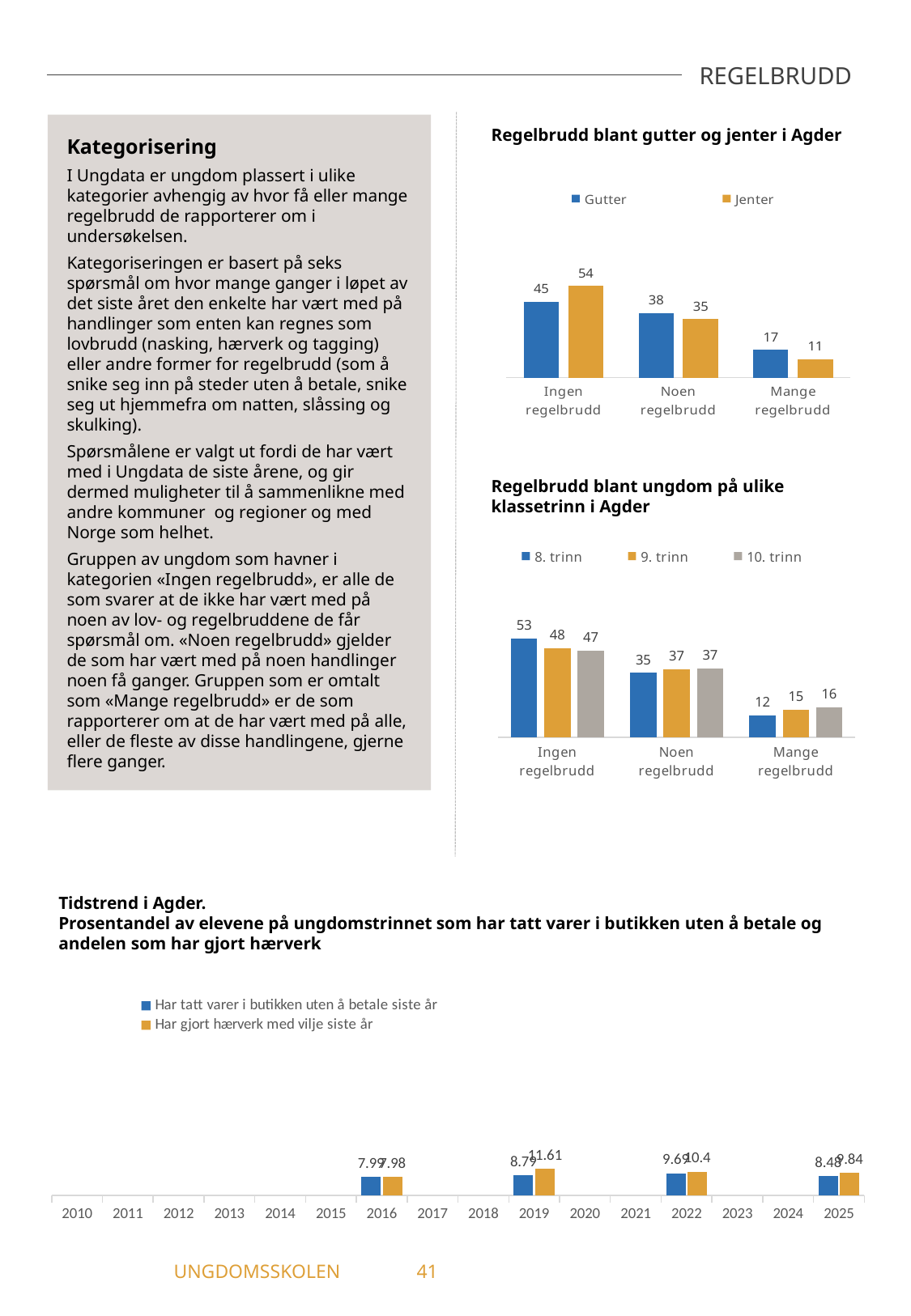
How many series does the legend list in the chart 'Regelbrudd blant gutter og jenter i Agder'? 2 How many categories are shown on the x axis of the chart 'Regelbrudd blant ungdom på ulike klassetrinn i Agder'? 3 What kind of chart is 'Regelbrudd blant ungdom på ulike klassetrinn i Agder'? Bar chart In the chart 'Regelbrudd blant gutter og jenter i Agder', what is the difference between Gutter and Jenter in the 'Ingen regelbrudd' category? 9 In the chart 'Regelbrudd blant gutter og jenter i Agder', which series has the higher value for 'Noen regelbrudd'? Gutter In the chart 'Regelbrudd blant ungdom på ulike klassetrinn i Agder', what is the difference between 8. trinn and 10. trinn in the 'Ingen regelbrudd' category? 6 In the chart 'Regelbrudd blant gutter og jenter i Agder', what is the value for Gutter in the 'Mange regelbrudd' category? 17 In the chart 'Tidstrend i Agder', what is the value for 'Har gjort hærverk med vilje siste år' in 2019? 11.61 In the chart 'Regelbrudd blant ungdom på ulike klassetrinn i Agder', what is the value for 8. trinn in the 'Ingen regelbrudd' category? 53 In the chart 'Regelbrudd blant ungdom på ulike klassetrinn i Agder', which grade has the highest value for 'Mange regelbrudd'? 10. trinn In the chart 'Regelbrudd blant gutter og jenter i Agder', what is the value for Jenter in the 'Ingen regelbrudd' category? 54 In the chart 'Tidstrend i Agder', what is the value for 'Har tatt varer i butikken uten å betale siste år' in 2019? 8.79